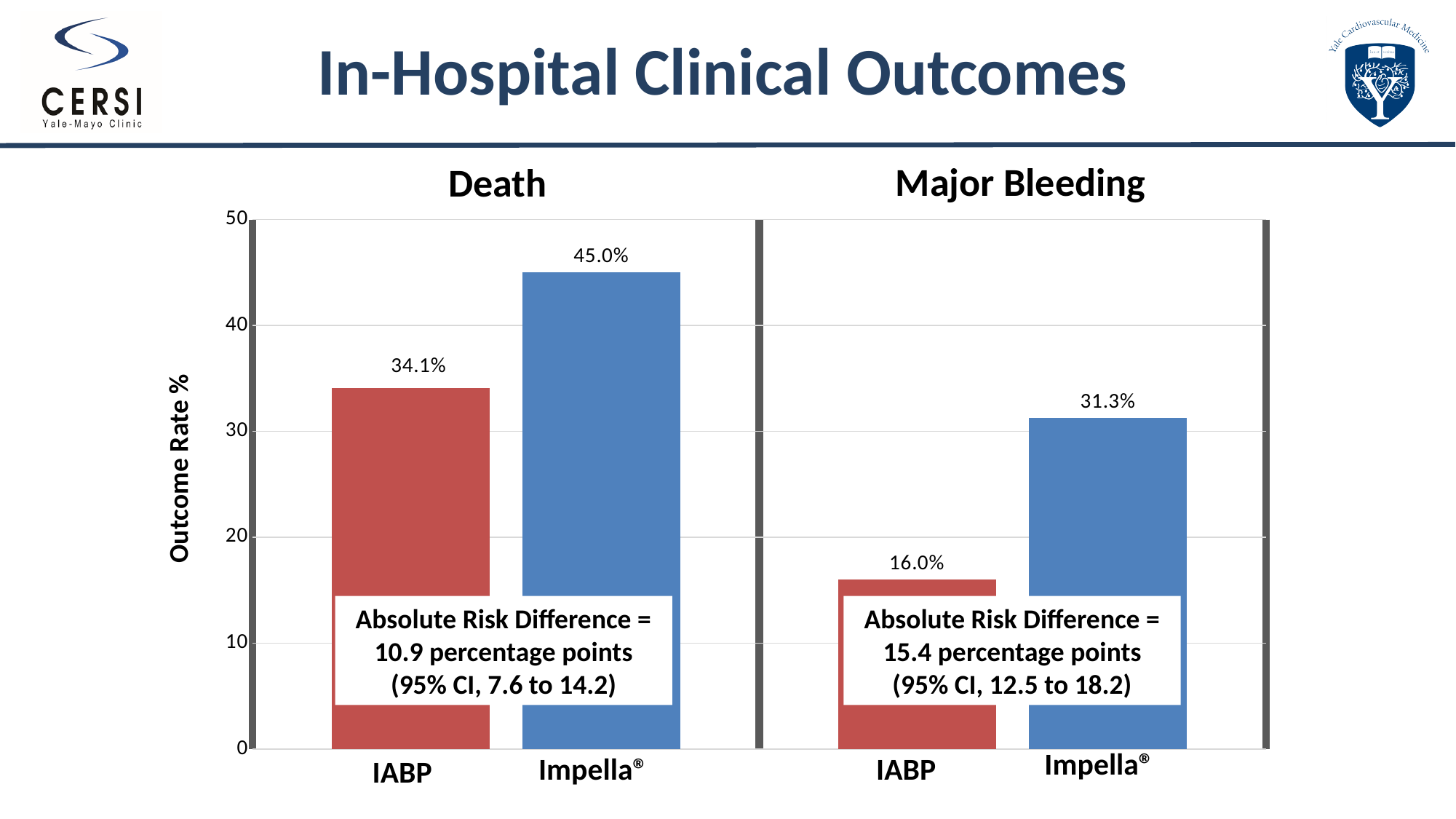
What kind of chart is used to show the Death outcomes? Bar chart In the Death chart, which group has the higher outcome rate? Impella In the Major Bleeding chart, what is the difference between the Impella and IABP outcome rates? 15.3 percentage points Is the IABP value in the Major Bleeding chart greater or less than 20? less In the Death chart, what is the outcome rate for Impella? 45.0% In the Death chart, what is the difference between the Impella and IABP outcome rates? 10.9 percentage points What is the label on the vertical axis of the charts? Outcome Rate % In the Major Bleeding chart, which group has the lower outcome rate? IABP In the Major Bleeding chart, what is the outcome rate for Impella? 31.3% In the Major Bleeding chart, what is the outcome rate for IABP? 16.0% Is the Impella value in the Death chart greater or less than 40? greater In the Death chart, what is the outcome rate for IABP? 34.1%